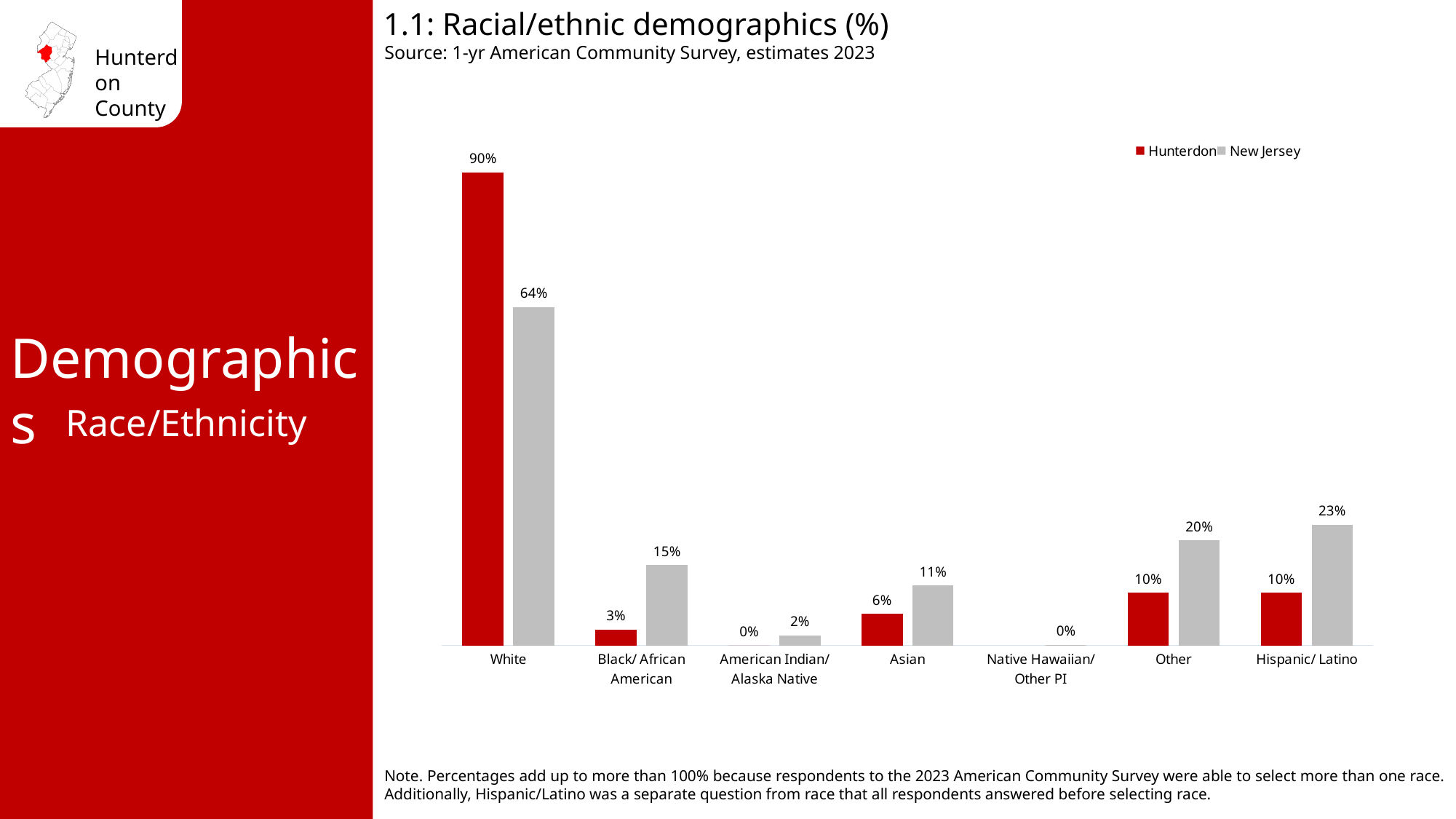
What kind of chart is shown on the slide? Bar chart What is the difference between the Hunterdon and New Jersey values for White? 26% How many series does the legend list? 2 What is the difference between the New Jersey and Hunterdon values for Other? 10% What is the Hunterdon value for Black/ African American? 3% Which is larger for Asian, the Hunterdon value or the New Jersey value? New Jersey Which category has the highest Hunterdon value? White What is the New Jersey value for Hispanic/ Latino? 23% What is the New Jersey value for Asian? 11% What is the Hunterdon value for White? 90% How many categories are shown on the x axis? 7 Which category has the lowest New Jersey value? Native Hawaiian/ Other PI